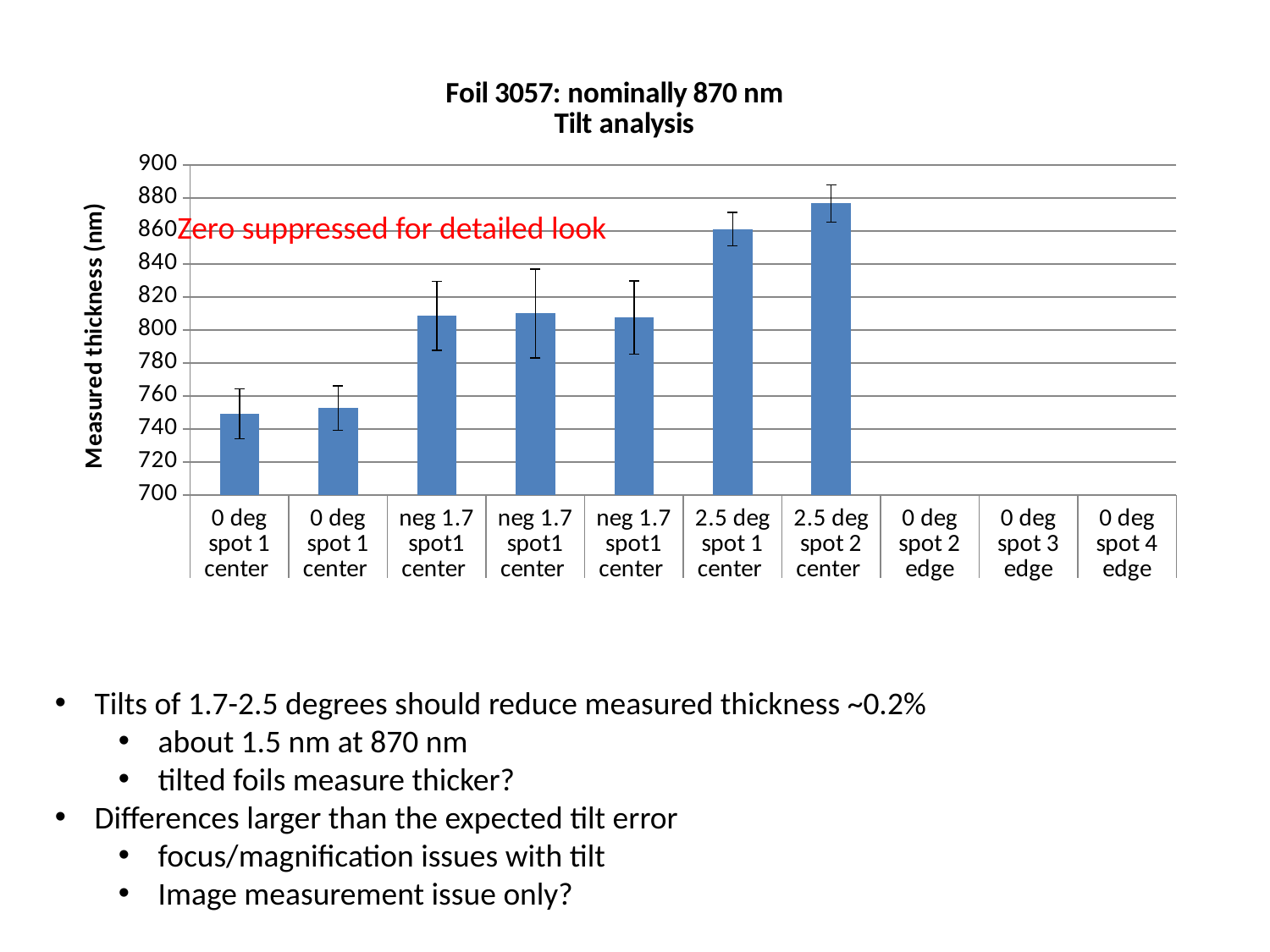
Is the value for the first 0 deg spot 1 center bar greater or less than 760? less What kind of chart is shown on the slide? bar chart Do the plotted bar values generally rise or fall from left to right along the x axis? rise Is the value for 2.5 deg spot 1 center greater or less than 840? greater Is the value for 2.5 deg spot 2 center greater or less than 860? greater How many categories have a visible bar plotted? 7 Which is larger, the value for 2.5 deg spot 1 center or the value for the first neg 1.7 spot1 center bar? 2.5 deg spot 1 center How many categories are listed along the x axis? 10 What is the title of the chart? Foil 3057: nominally 870 nm Tilt analysis Among the plotted bars, which category has the lowest measured thickness? 0 deg spot 1 center What is the label of the vertical axis? Measured thickness (nm) Which category has the highest measured thickness? 2.5 deg spot 2 center